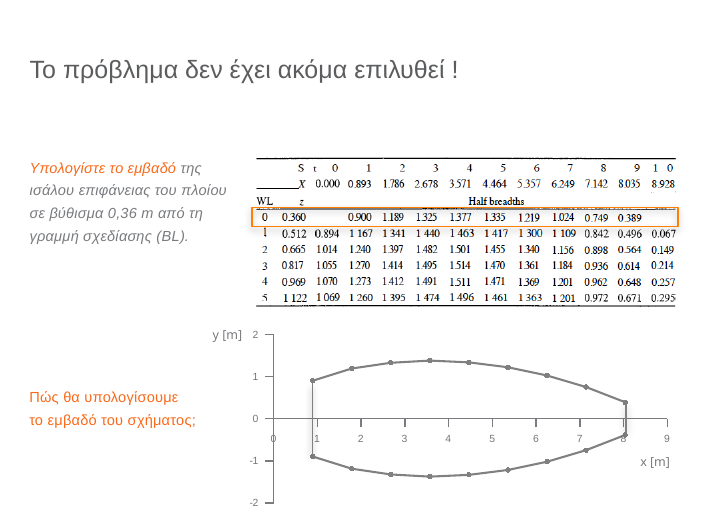
Does the upper curve rise or fall as x increases from 1 to 3.5? rise Is the highest point of the upper curve greater or less than 2? less Is the y value of the upper curve at x = 2 greater or less than 0? greater Is the y value of the lower curve at x = 3.5 greater or less than -1? less Does the upper curve rise or fall as x increases from 4 to 9? fall What is the label of the vertical axis of the chart? y [m] What kind of chart is shown at the bottom of the slide? line chart What is the largest tick value shown on the x axis of the chart? 9 What is the label of the horizontal axis of the chart? x [m]